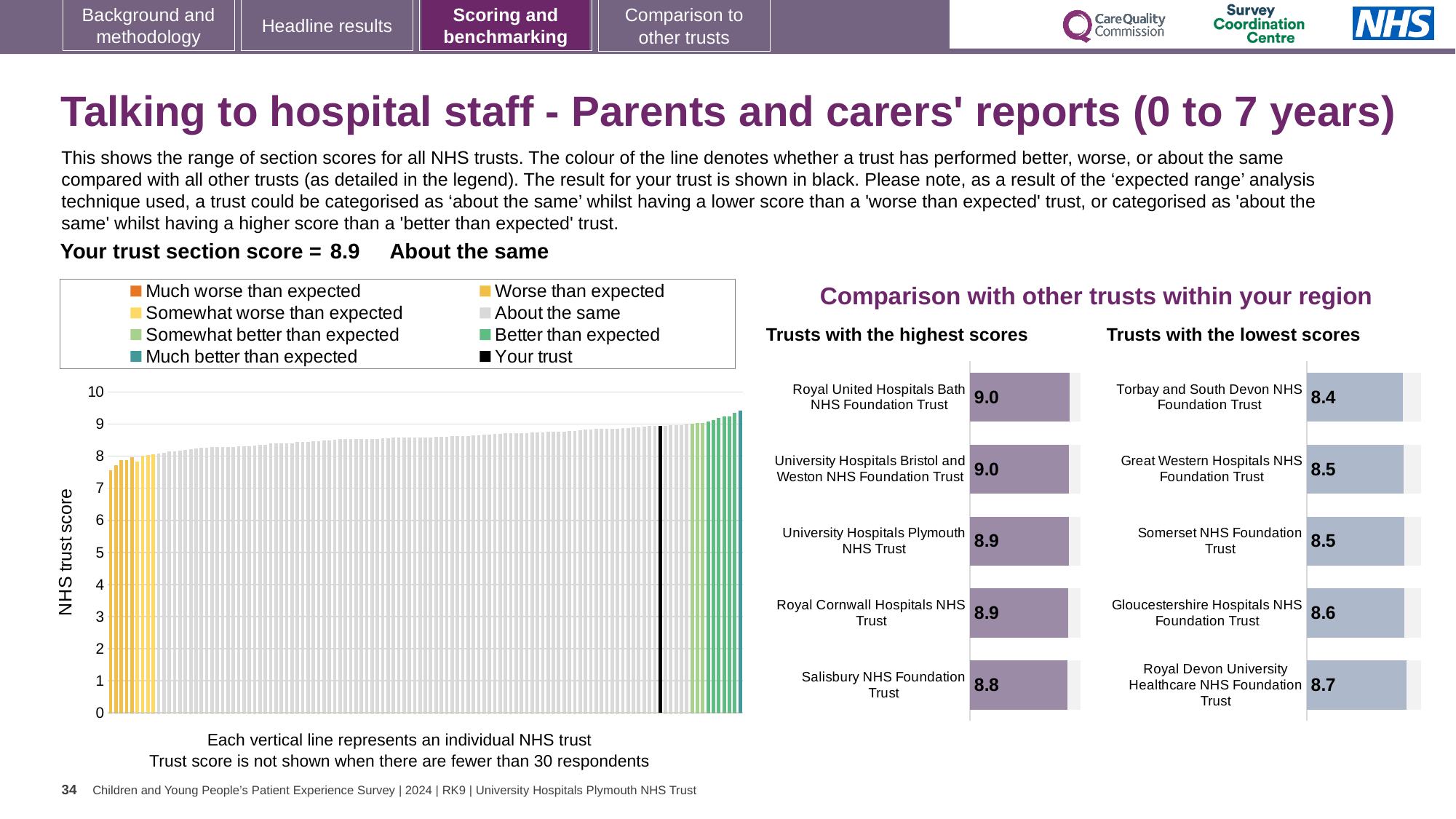
In the 'Trusts with the highest scores' chart, what is the difference between the scores of Royal United Hospitals Bath NHS Foundation Trust and Salisbury NHS Foundation Trust? 0.2 How many entries does the legend of the NHS trust score chart on the left list? 8 In the 'Trusts with the lowest scores' chart, which has the higher score: Gloucestershire Hospitals NHS Foundation Trust or Torbay and South Devon NHS Foundation Trust? Gloucestershire Hospitals NHS Foundation Trust In the 'Trusts with the lowest scores' chart, which trust has the highest score? Royal Devon University Healthcare NHS Foundation Trust In the NHS trust score chart on the left, is the value of the black bar (your trust) greater or less than 8? greater In the 'Trusts with the lowest scores' chart, what is the difference between the scores of Royal Devon University Healthcare NHS Foundation Trust and Torbay and South Devon NHS Foundation Trust? 0.3 In the 'Trusts with the lowest scores' chart, which trust has the lowest score? Torbay and South Devon NHS Foundation Trust In the 'Trusts with the highest scores' chart, what is the score for Salisbury NHS Foundation Trust? 8.8 How many trusts are shown in the 'Trusts with the highest scores' chart? 5 In the 'Trusts with the lowest scores' chart, what is the score for Torbay and South Devon NHS Foundation Trust? 8.4 In the 'Trusts with the lowest scores' chart, what is the score for Gloucestershire Hospitals NHS Foundation Trust? 8.6 What kind of chart is the NHS trust score chart on the left of the slide? Bar chart